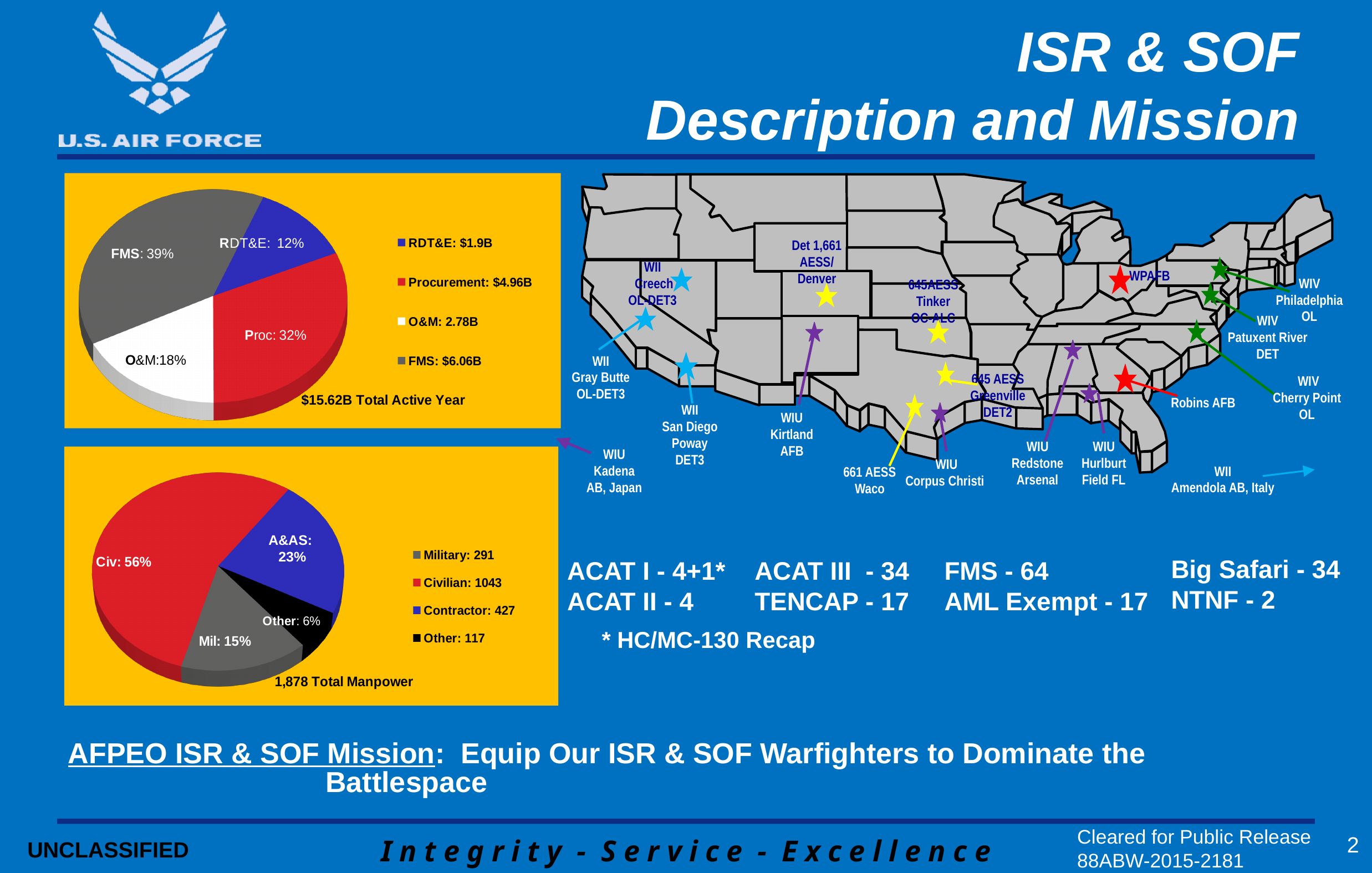
In the bottom-left pie chart, what percentage share is labelled for Mil? 15% In the top-left pie chart, what is the difference between the FMS value and the RDT&E value shown in the legend? $4.16B In the bottom-left pie chart, which category has the largest slice? Civilian In the top-left pie chart, what total is printed below the pie? $15.62B Total Active Year In the bottom-left pie chart, which is larger, Military or Other? Military In the top-left pie chart, what is the value shown in the legend for Procurement? $4.96B In the top-left pie chart, what percentage share is labelled for FMS? 39% In the bottom-left pie chart, what is the value shown in the legend for Contractor? 427 How many categories does the legend of the bottom-left pie chart list? 4 In the top-left pie chart, which category has the smallest slice? RDT&E What type of chart is used in the top-left panel of the slide? Pie chart In the top-left pie chart, which category has the largest slice? FMS